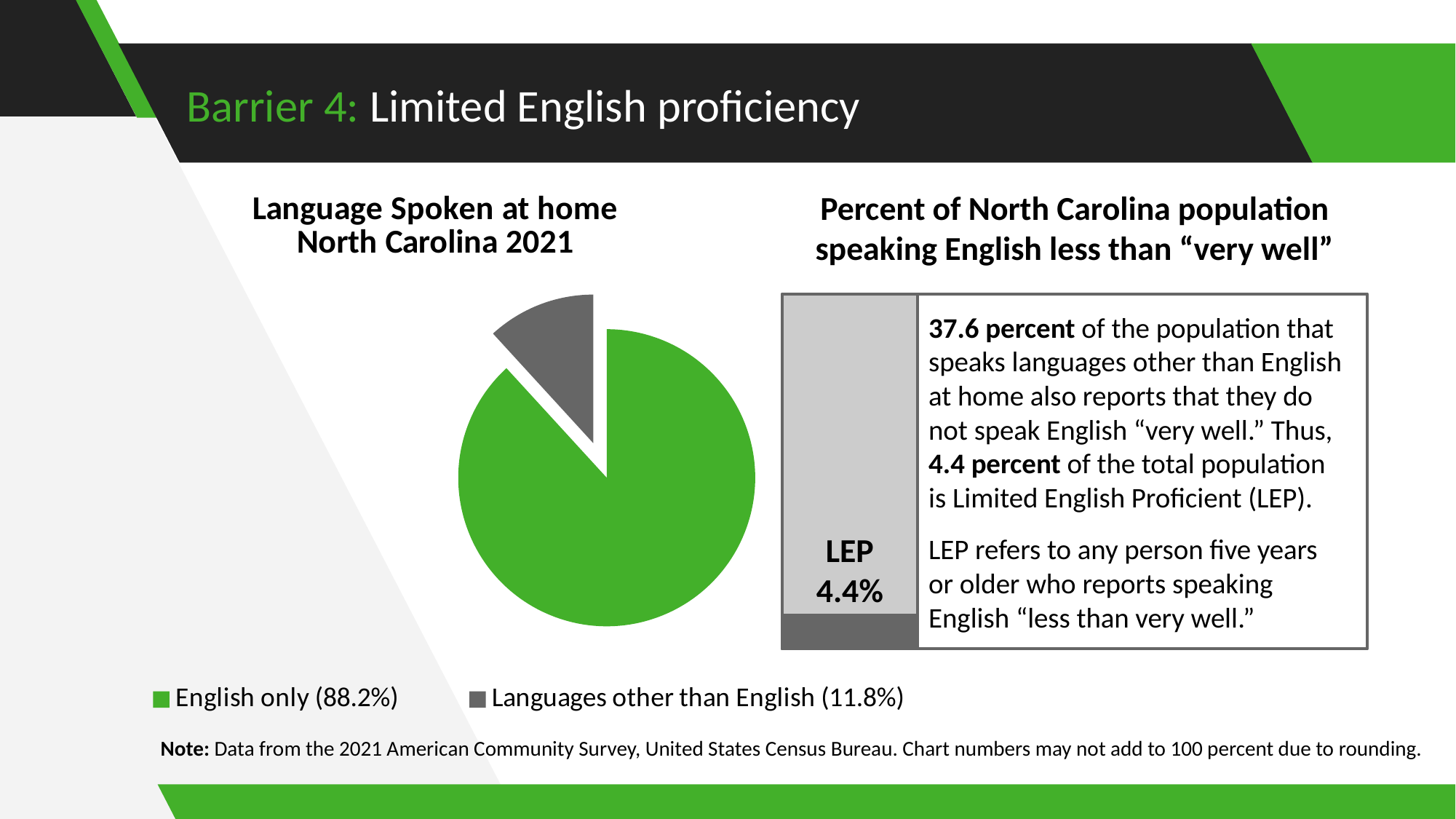
In the 'Language Spoken at home North Carolina 2021' chart, what kind of chart is shown? pie chart In the 'Language Spoken at home North Carolina 2021' pie chart, which is larger: 'English only' or 'Languages other than English'? English only In the 'Percent of North Carolina population speaking English less than "very well"' graphic on the right, what value is labelled for LEP? 4.4% In the 'Language Spoken at home North Carolina 2021' pie chart, how many entries does the legend list? 2 In the 'Language Spoken at home North Carolina 2021' pie chart, which slice is the smallest? Languages other than English In the 'Language Spoken at home North Carolina 2021' pie chart, what is the difference in percentage points between 'English only' and 'Languages other than English'? 76.4 In the 'Language Spoken at home North Carolina 2021' pie chart, what share of the pie is 'Languages other than English'? 11.8% In the 'Language Spoken at home North Carolina 2021' pie chart, what share of the pie is 'English only'? 88.2% In the 'Language Spoken at home North Carolina 2021' pie chart, which slice is the largest? English only In the 'Language Spoken at home North Carolina 2021' pie chart, how many slices does the pie have? 2 In the 'Language Spoken at home North Carolina 2021' pie chart, what colour is the 'Languages other than English' slice? grey In the 'Language Spoken at home North Carolina 2021' pie chart, what colour is the 'English only' slice? green